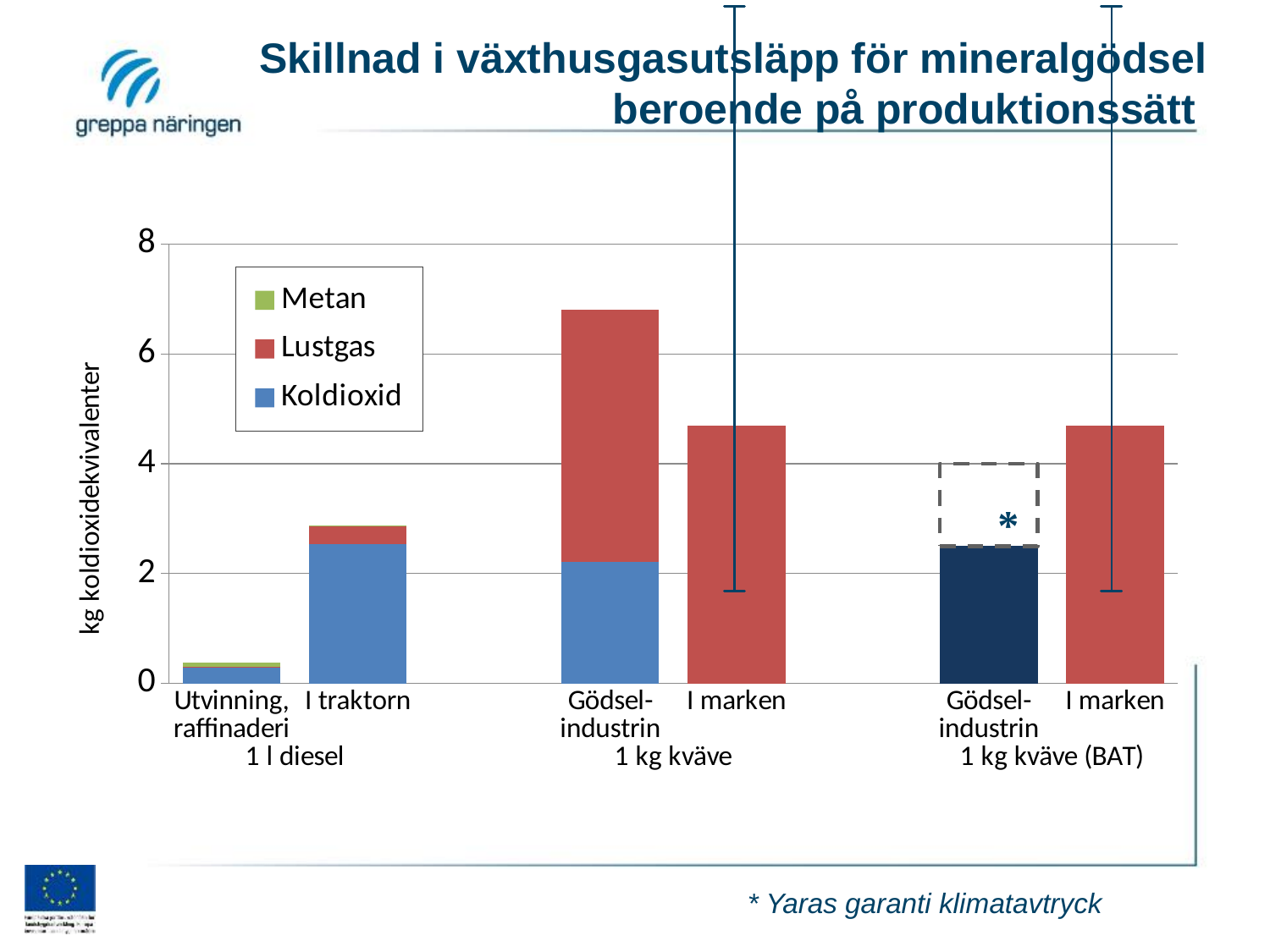
Is the value for I marken under 1 kg kväve greater or less than 4? greater Is the value for Utvinning, raffinaderi greater or less than 2? less Which bar is the highest in the chart? Gödsel-industrin (1 kg kväve) Which bar is the lowest in the chart? Utvinning, raffinaderi How many series does the legend list? 3 Is the total value for Gödsel-industrin under 1 kg kväve greater or less than 6? greater How many bars are plotted in the chart? 6 What kind of chart is shown on the slide? bar chart Which colour represents Lustgas in the legend? red What is the label on the vertical axis? kg koldioxidekvivalenter Which is larger: the bar for I traktorn or the bar for Gödsel-industrin under 1 kg kväve? Gödsel-industrin (1 kg kväve)